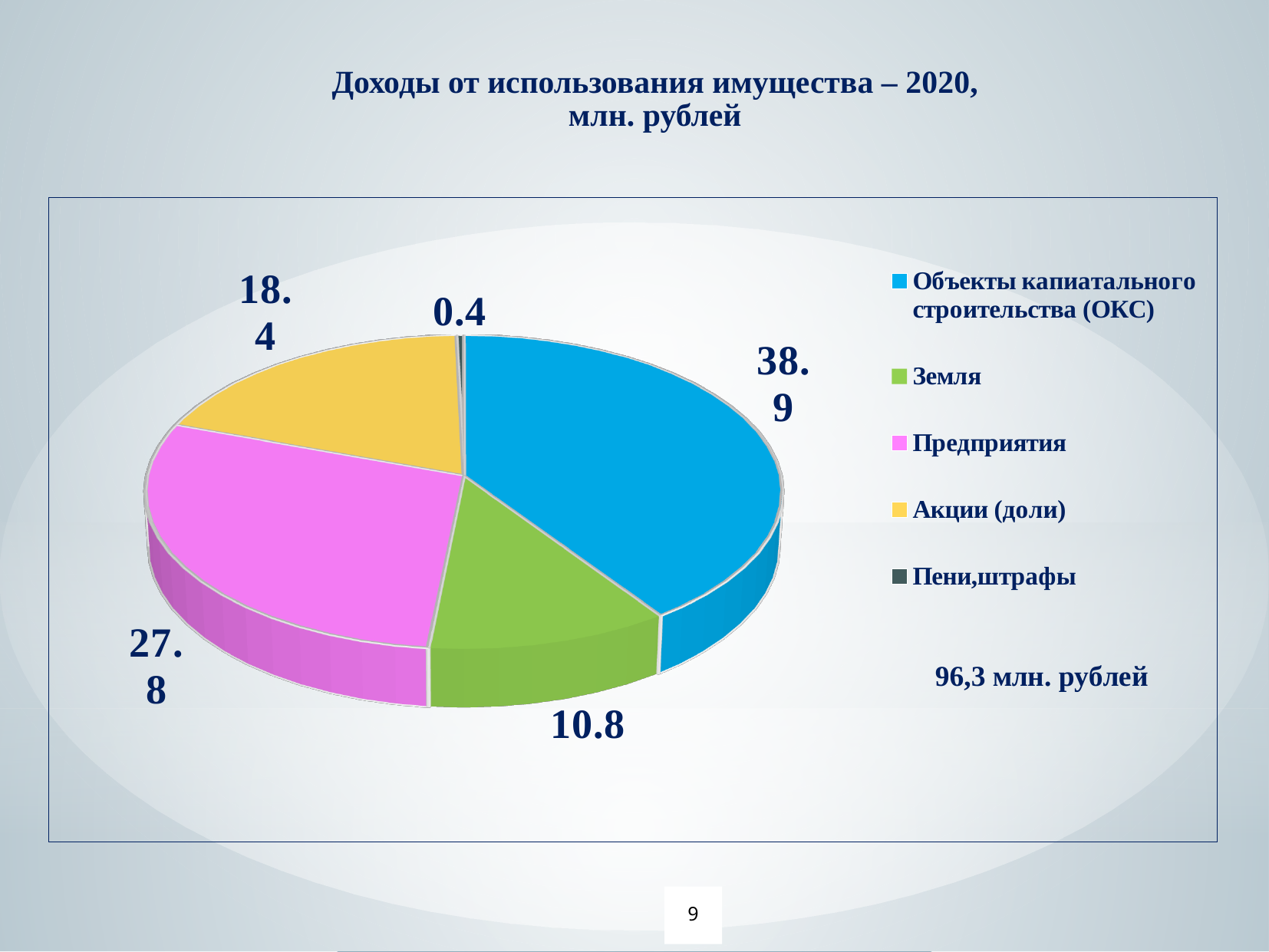
How many categories does the legend list? 5 What is the value for Акции (доли)? 18.4 Which is larger, the value for Акции (доли) or the value for Земля? Акции (доли) Which category has the largest slice of the pie? Объекты капиатального строительства (ОКС) What is the value for Пени,штрафы? 0.4 What total amount in млн. рублей is printed on the slide next to the chart? 96,3 млн. рублей What is the value for Предприятия? 27.8 Which category has the smallest slice of the pie? Пени,штрафы What is the value for Земля? 10.8 What is the difference between the values for Объекты капиатального строительства (ОКС) and Предприятия? 11.1 What type of chart is shown on the slide? Pie chart What is the value for Объекты капиатального строительства (ОКС)? 38.9